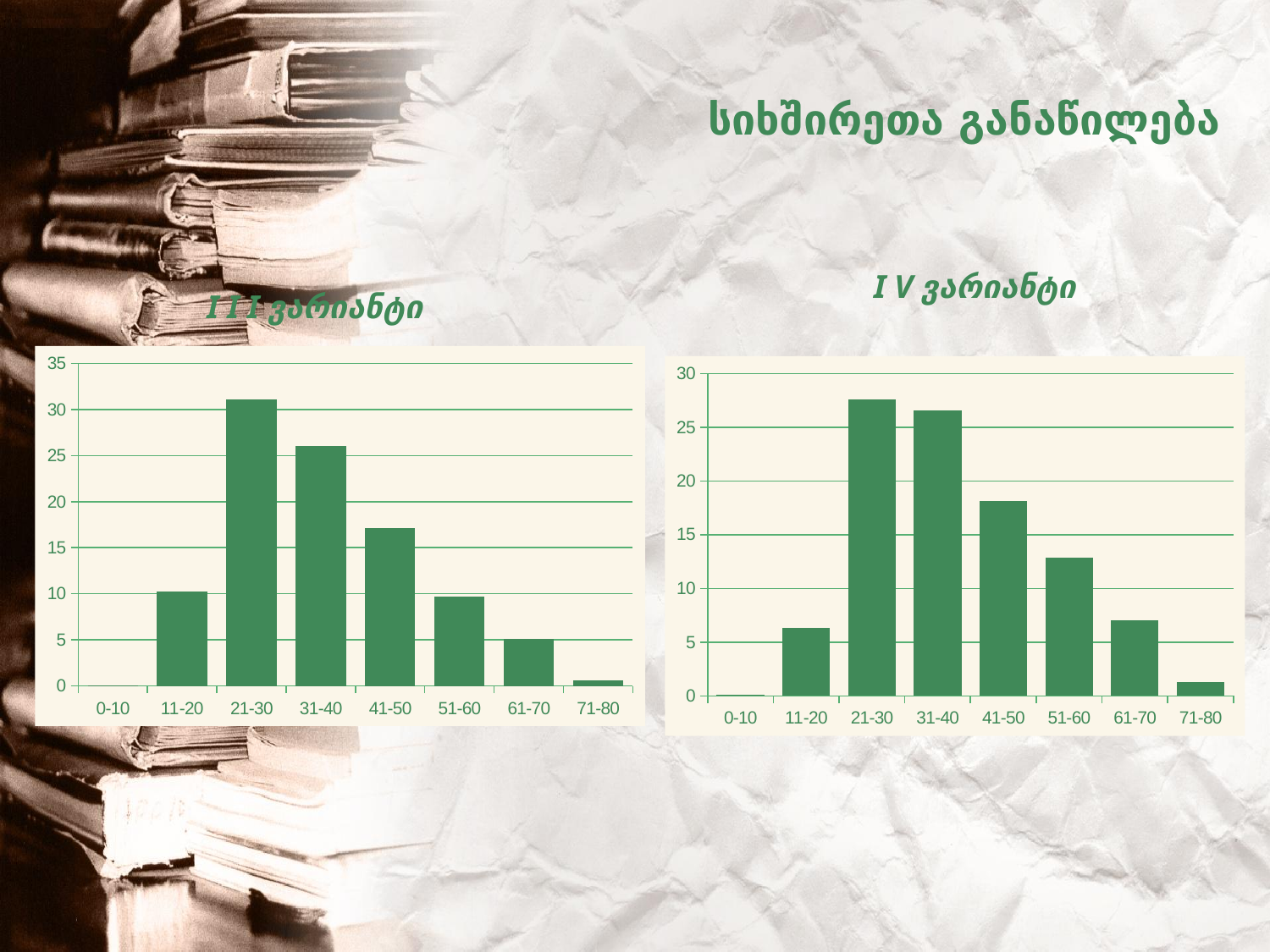
What kind of chart is the left chart (III ვარიანტი)? bar chart In the right chart (IV ვარიანტი), is the value for 11-20 greater or less than 10? less In the left chart (III ვარიანტი), do the values rise or fall from 21-30 to 71-80? fall What is the highest value shown on the y axis of the left chart (III ვარიანტი)? 35 How many categories are shown on the x axis of the right chart (IV ვარიანტი)? 8 In the left chart (III ვარიანტი), which category has the lowest value? 0-10 In the right chart (IV ვარიანტი), is the value for 41-50 greater or less than 15? greater In the left chart (III ვარიანტი), which category has the highest bar? 21-30 In the right chart (IV ვარიანტი), which is larger, the value for 51-60 or the value for 61-70? 51-60 In the left chart (III ვარიანტი), which is larger, the value for 41-50 or the value for 51-60? 41-50 In the left chart (III ვარიანტი), is the value for 21-30 greater or less than 30? greater In the right chart (IV ვარიანტი), which category has the highest bar? 21-30